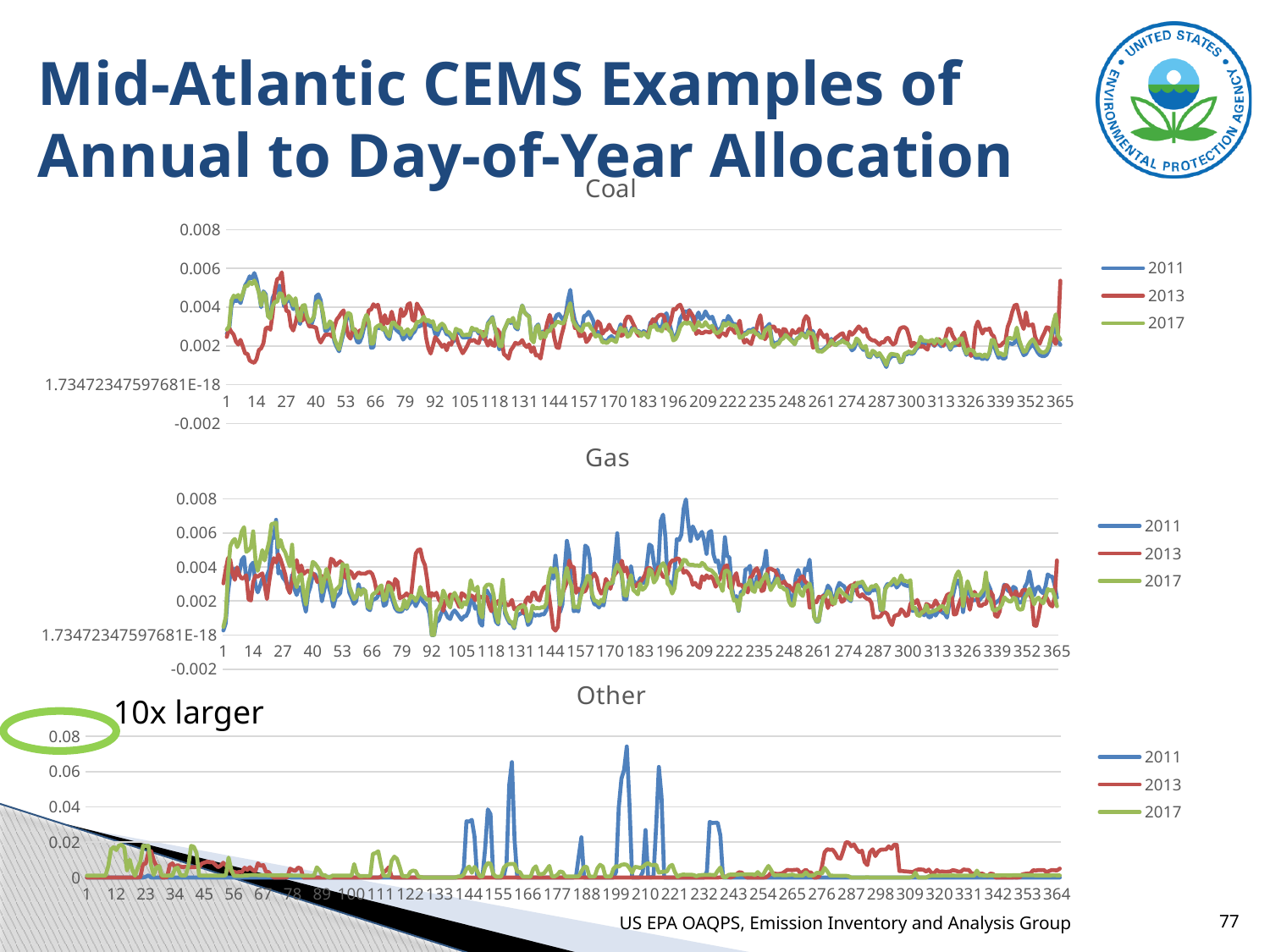
Which years are listed in the legend of the Other chart? 2011, 2013, 2017 In the Other chart, is the highest peak of the 2011 series greater or less than 0.06? greater In the Gas chart, which series reaches the highest peak? 2011 What is the highest value shown on the y axis of the Other chart? 0.08 In the Other chart, is the highest value of the 2017 series greater or less than 0.04? less How many charts are shown on the slide? 3 What kind of chart is the Coal chart? line chart In the Other chart, which series reaches the highest peak? 2011 In the Other chart, which series has the larger peak: 2011 or 2013? 2011 How many series does the legend of the Gas chart list? 3 What is the title of the middle chart on the slide? Gas In the Gas chart, is the highest peak of the 2011 series greater or less than 0.006? greater